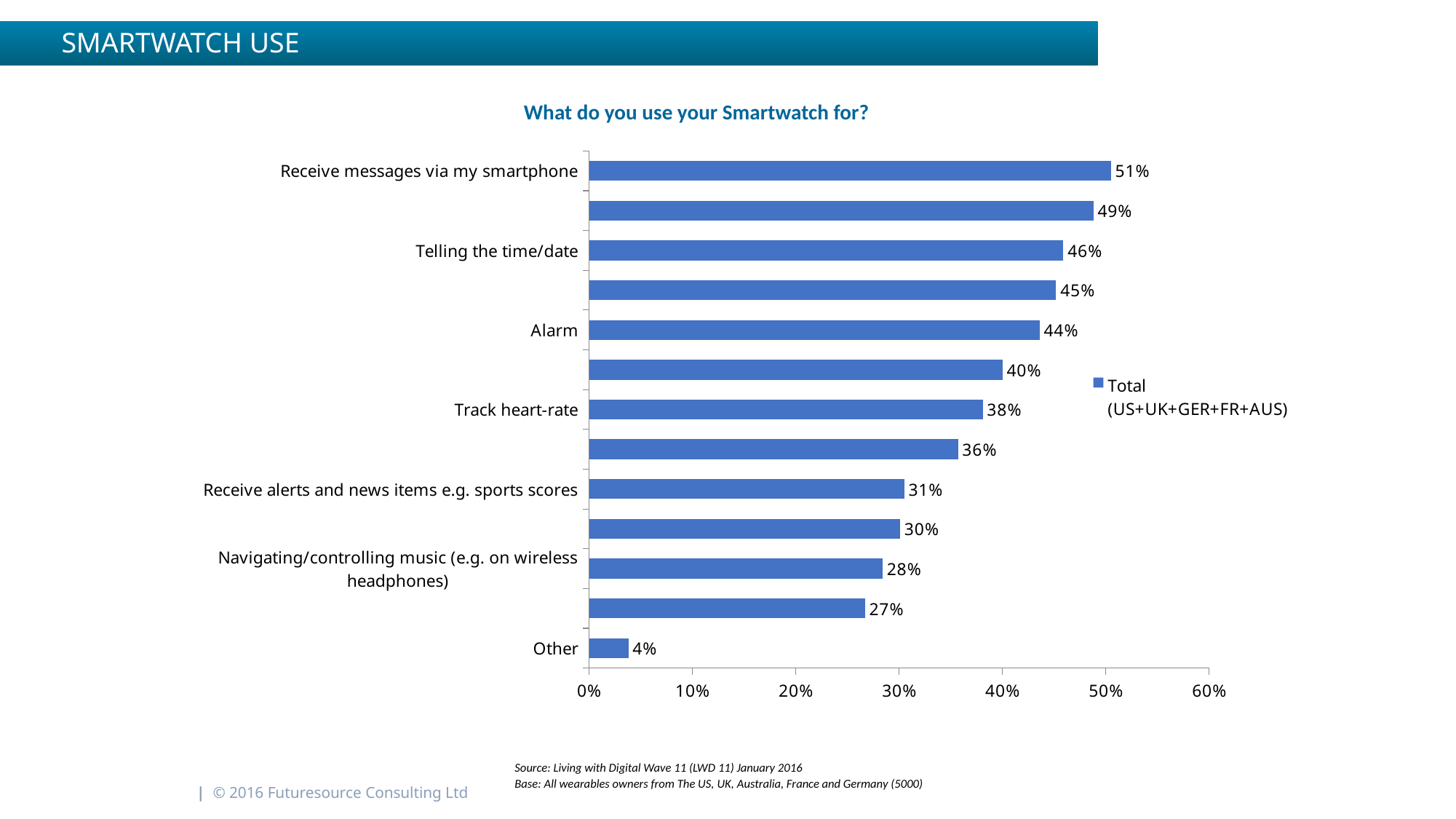
What percentage use their smartwatch for navigating/controlling music (e.g. on wireless headphones)? 28% Which is larger: the value for 'Alarm' or the value for 'Track heart-rate'? Alarm Which labelled category has the highest value? Receive messages via my smartphone What percentage of respondents use their smartwatch to receive messages via their smartphone? 51% What percentage use their smartwatch as an alarm? 44% How many bars are plotted in the chart? 13 What is the difference between 'Receive messages via my smartphone' and 'Telling the time/date'? 5 percentage points What is the value for 'Track heart-rate'? 38% What is the legend entry for the series shown in the chart? Total (US+UK+GER+FR+AUS) What is the value for 'Telling the time/date'? 46% What type of chart is shown on the slide? Bar chart Which category has the lowest value? Other